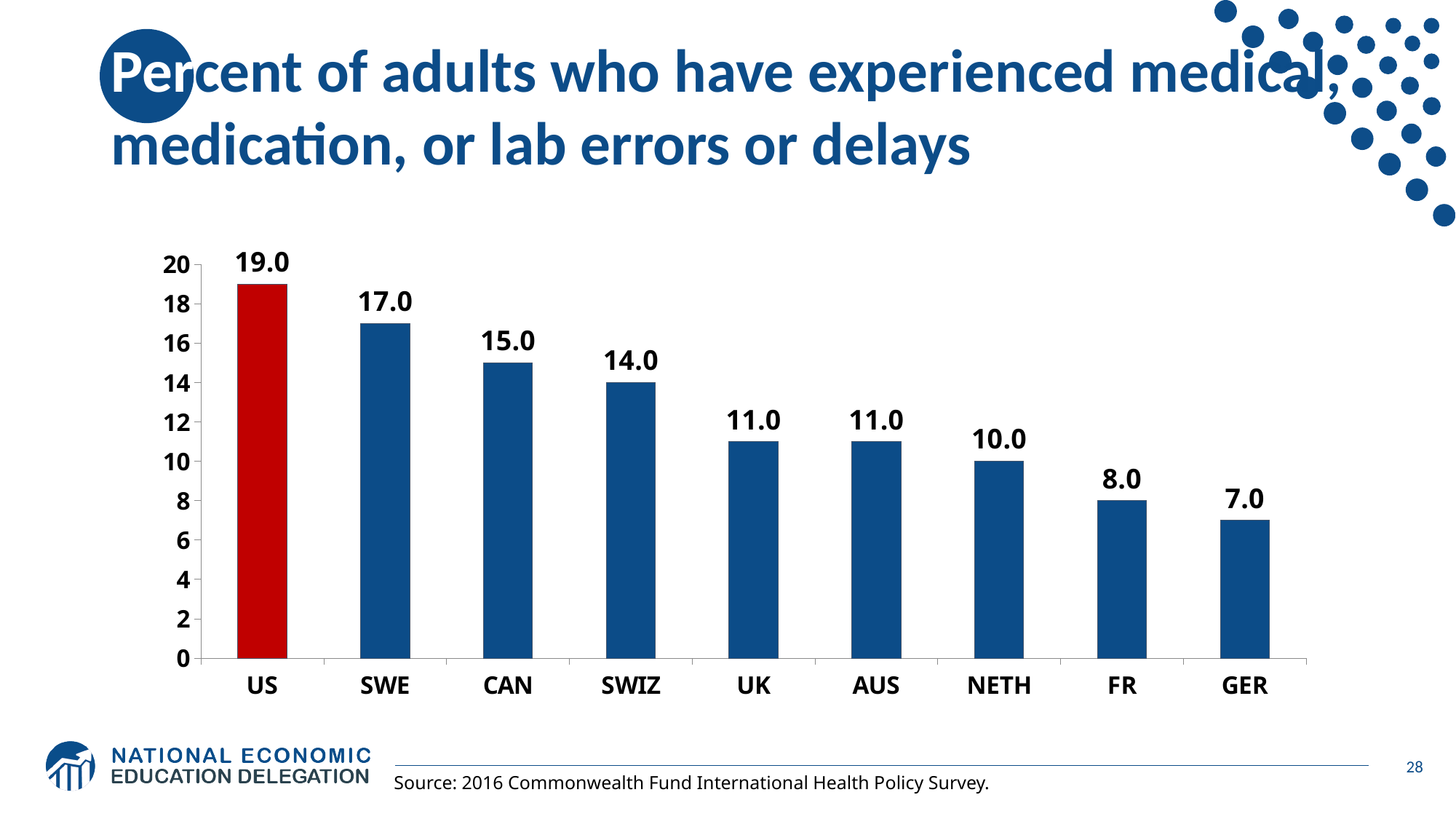
How many countries are shown on the chart? 9 What is the value for SWIZ? 14.0 Which country has the highest value? US Which is larger, the value for FR or the value for NETH? NETH Which bar is coloured red rather than blue? US Which country has the lowest value? GER What is the value for NETH? 10.0 What is the difference between the values for the US and SWE? 2.0 What kind of chart is shown on the slide? bar chart What is the difference between the values for CAN and GER? 8.0 Is the value for CAN greater or less than 10? greater What is the value for the US? 19.0